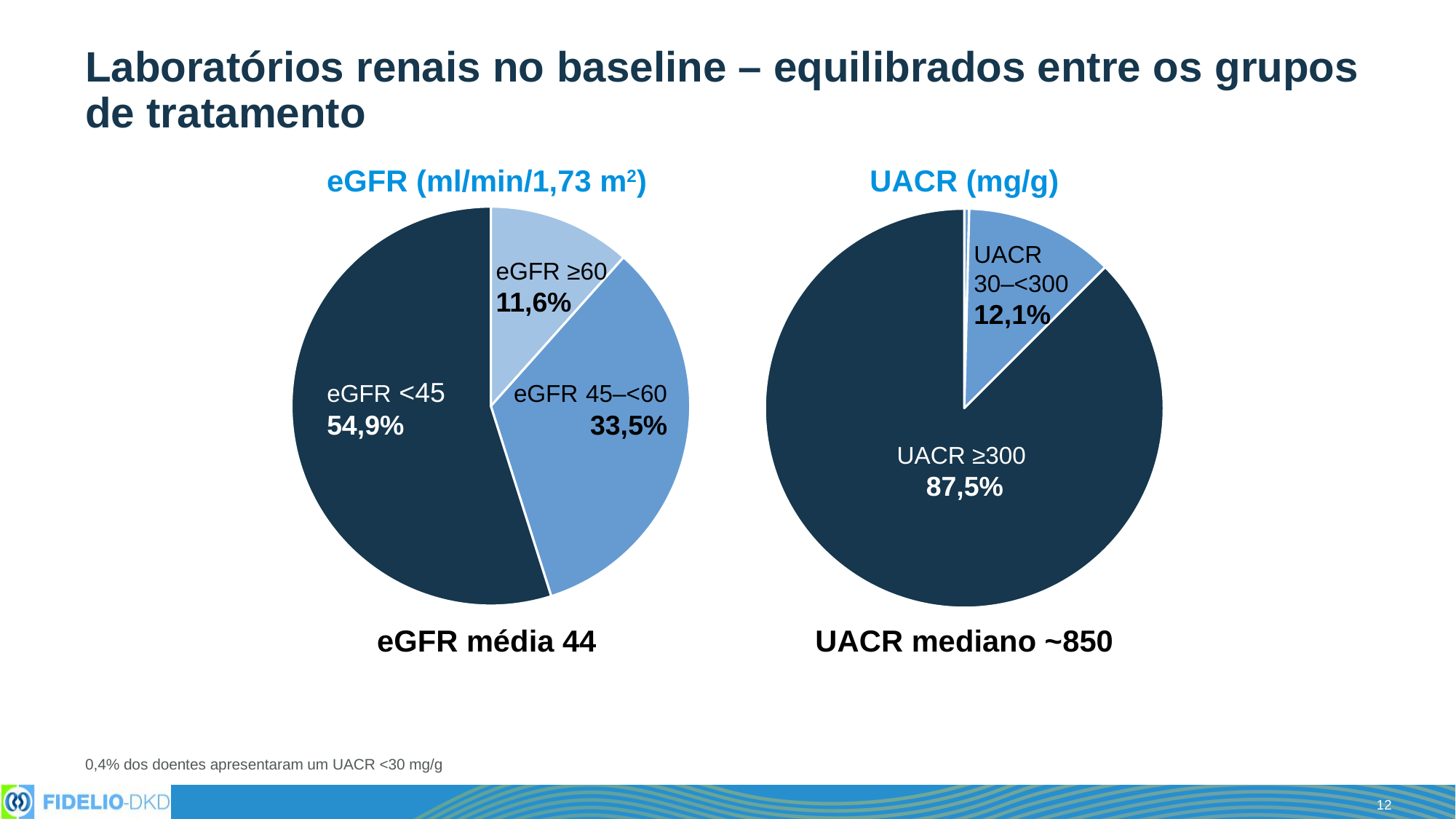
In the UACR (mg/g) chart, what is the difference between the UACR ≥300 share and the UACR 30–<300 share? 75,4% In the eGFR (ml/min/1,73 m²) chart, what share of patients have eGFR ≥60? 11,6% In the eGFR (ml/min/1,73 m²) chart, what share of patients have eGFR 45–<60? 33,5% In the UACR (mg/g) chart, what share of patients have UACR ≥300? 87,5% What kind of chart is used for the eGFR (ml/min/1,73 m²) data? Pie chart In the eGFR (ml/min/1,73 m²) chart, what is the difference between the eGFR <45 share and the eGFR 45–<60 share? 21,4% In the eGFR (ml/min/1,73 m²) chart, which category has the largest slice? eGFR <45 In the UACR (mg/g) chart, what share of patients have UACR 30–<300? 12,1% In the eGFR (ml/min/1,73 m²) chart, what share of patients have eGFR <45? 54,9% How many labelled categories does the eGFR (ml/min/1,73 m²) chart show? 3 In the UACR (mg/g) chart, which labelled category has the largest slice? UACR ≥300 In the eGFR (ml/min/1,73 m²) chart, which category has the smallest slice? eGFR ≥60